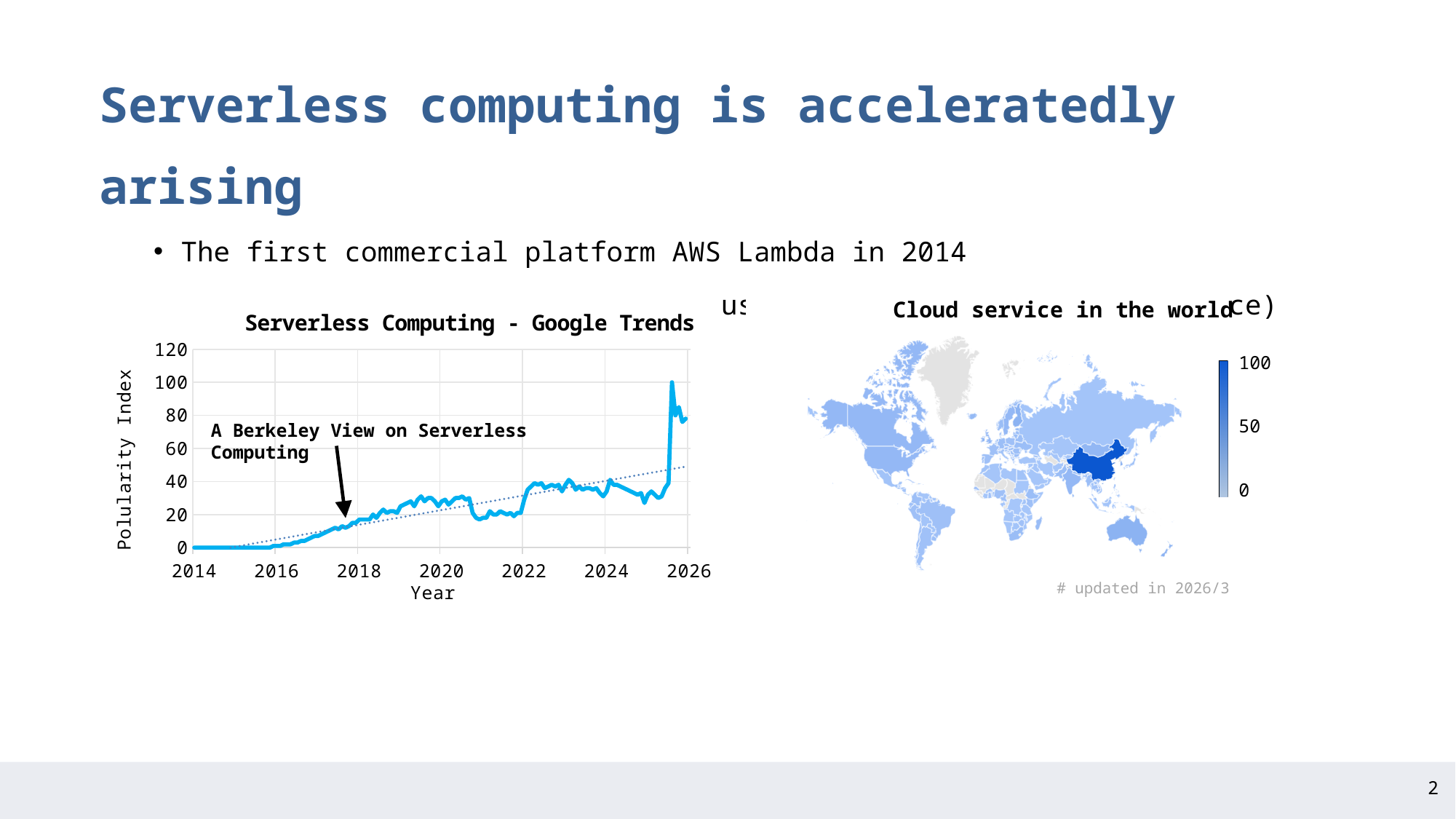
In the 'Serverless Computing - Google Trends' chart, is the peak value of the line greater or less than 80? greater In the 'Serverless Computing - Google Trends' chart, do the values generally rise or fall from 2014 to 2026? rise In the 'Serverless Computing - Google Trends' chart, what is the highest tick value shown on the y axis? 120 What kind of chart is the 'Serverless Computing - Google Trends' chart? line chart In the 'Cloud service in the world' map, what is the maximum value on the colour scale? 100 In the 'Serverless Computing - Google Trends' chart, is the value at the start of 2016 greater or less than 20? less In the 'Serverless Computing - Google Trends' chart, what is the Polularity Index value at the start of 2014? 0 In the 'Serverless Computing - Google Trends' chart, what event does the arrow annotation label? A Berkeley View on Serverless Computing In the 'Serverless Computing - Google Trends' chart, in which year does the line reach its highest point? 2025 In the 'Cloud service in the world' map, which country is shaded the darkest? China In the 'Serverless Computing - Google Trends' chart, is the value at the start of 2020 larger or smaller than the value at the start of 2016? larger In the 'Serverless Computing - Google Trends' chart, is the value at the start of 2022 greater or less than 60? less